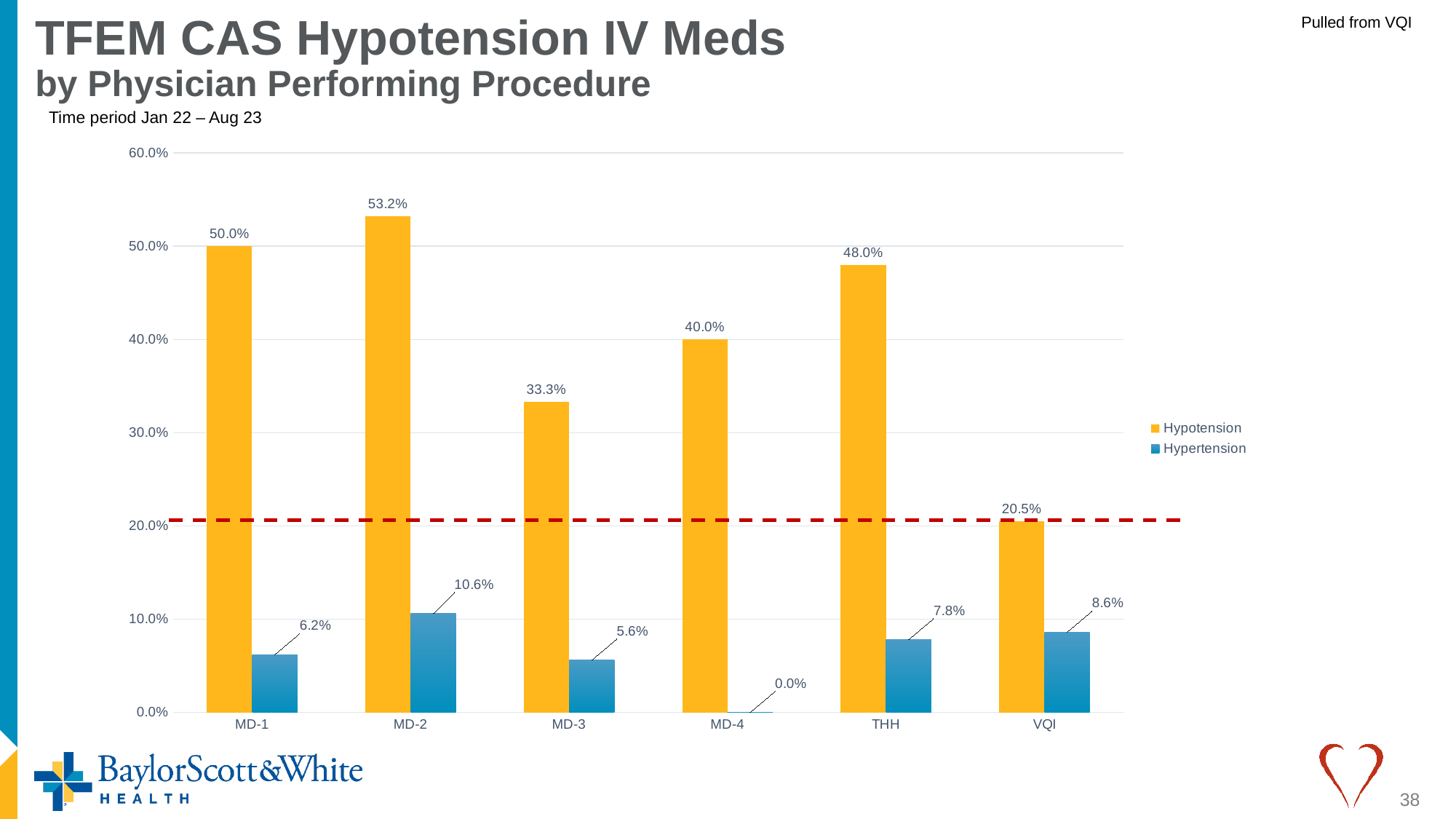
What is the Hypotension value for MD-2? 53.2% How many categories are shown on the x axis? 6 What is the Hypertension value for THH? 7.8% What is the Hypotension value for VQI? 20.5% What colour are the Hypotension bars? orange Which category has the highest Hypotension value? MD-2 Which category has the lowest Hypertension value? MD-4 Which is larger, the Hypertension value for MD-2 or for VQI? MD-2 How many series does the legend list? 2 Is the Hypotension value for THH greater or less than 40.0%? greater What kind of chart is shown on the slide? bar chart What is the difference between the Hypotension values for MD-1 and MD-3? 16.7%